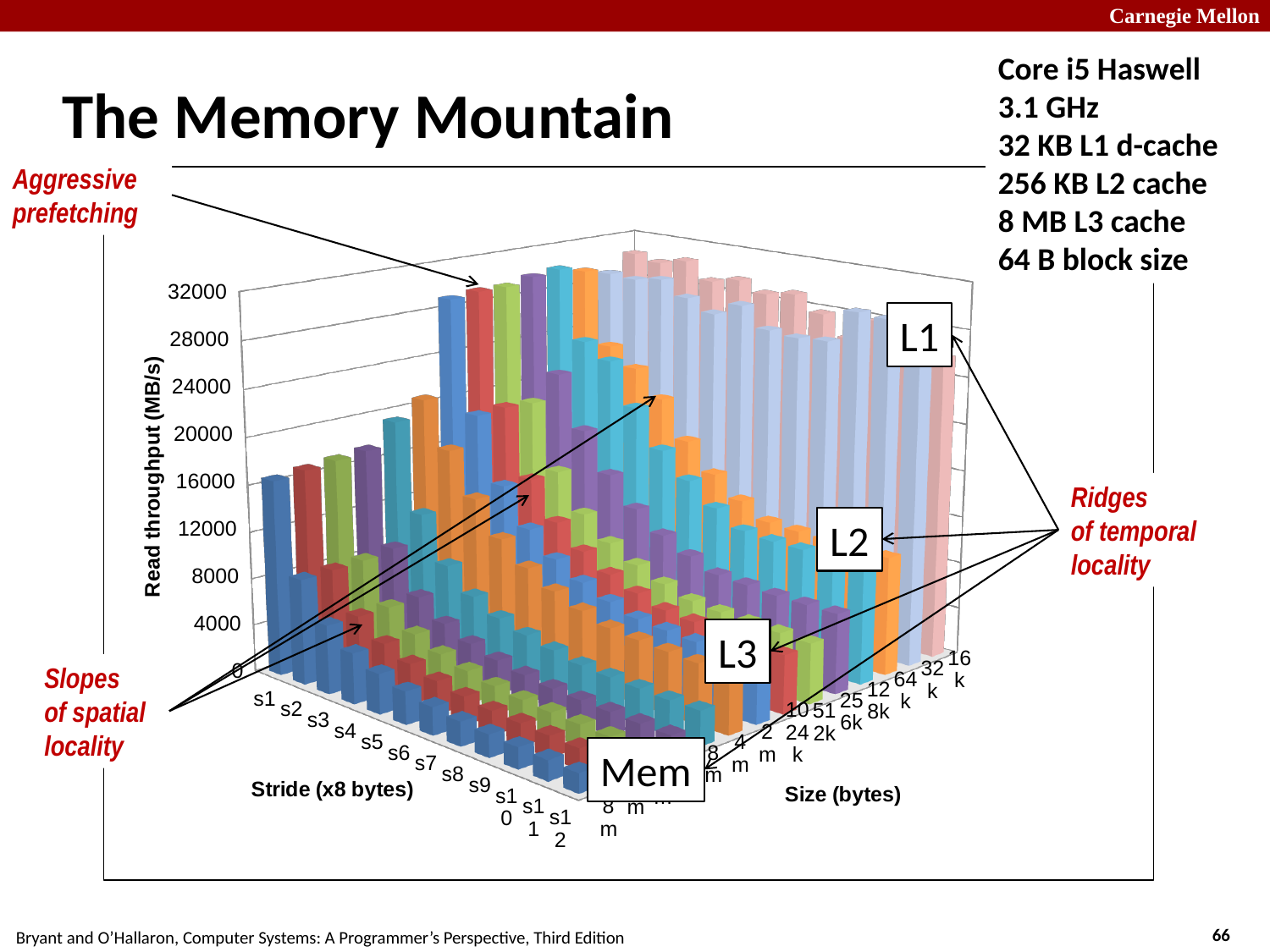
Which region of the chart has higher read throughput, the L1 ridge or the Mem region? L1 Is the read throughput for stride s12 at the largest size (8m, the Mem region) greater or less than 8000? less What is the label of the vertical axis of the chart? Read throughput (MB/s) For a fixed size, does read throughput rise or fall as the stride increases from s1 to s12? fall What kind of chart is shown on the slide? bar chart What is the label of the stride axis of the chart? Stride (x8 bytes) How many stride categories (s1 through s12) are shown along the stride axis? 12 What is the highest tick value shown on the read throughput axis? 32000 For a fixed stride, does read throughput rise or fall as the working-set size increases from 16k to 8m? fall Is the read throughput for the tallest bars in the L1 region greater or less than 28000? greater